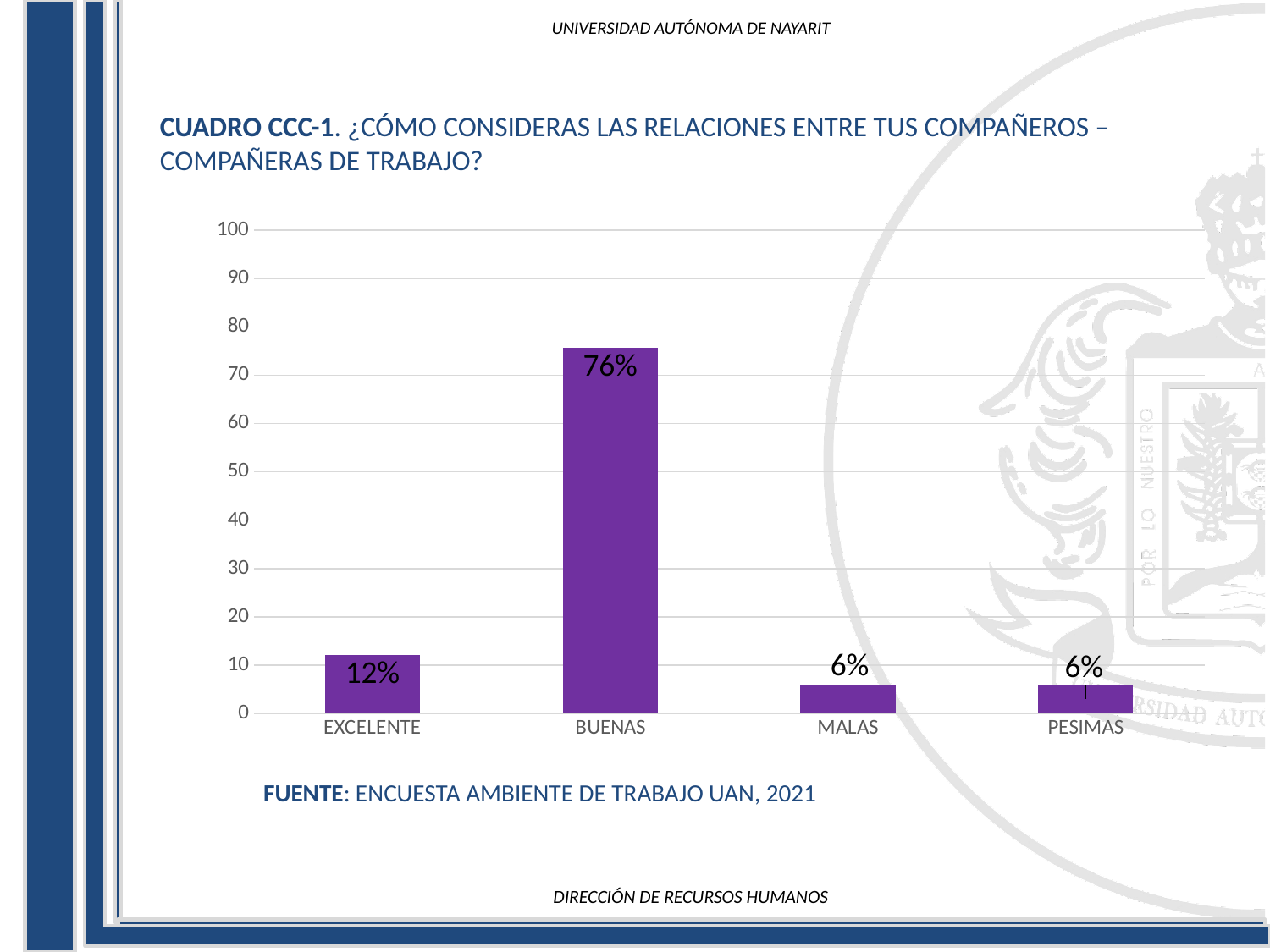
How many categories are shown on the x axis? 4 What is the value for BUENAS? 76% What is the value for EXCELENTE? 12% Which is larger, the value for EXCELENTE or the value for PESIMAS? EXCELENTE What is the value for MALAS? 6% Is the value for MALAS greater or less than 10? less What colour are the bars in the chart? purple Which category has the highest value? BUENAS What is the source cited below the chart? ENCUESTA AMBIENTE DE TRABAJO UAN, 2021 Is the value for BUENAS greater or less than 70? greater What is the difference between the values for BUENAS and EXCELENTE? 64% What kind of chart is shown on the slide? bar chart